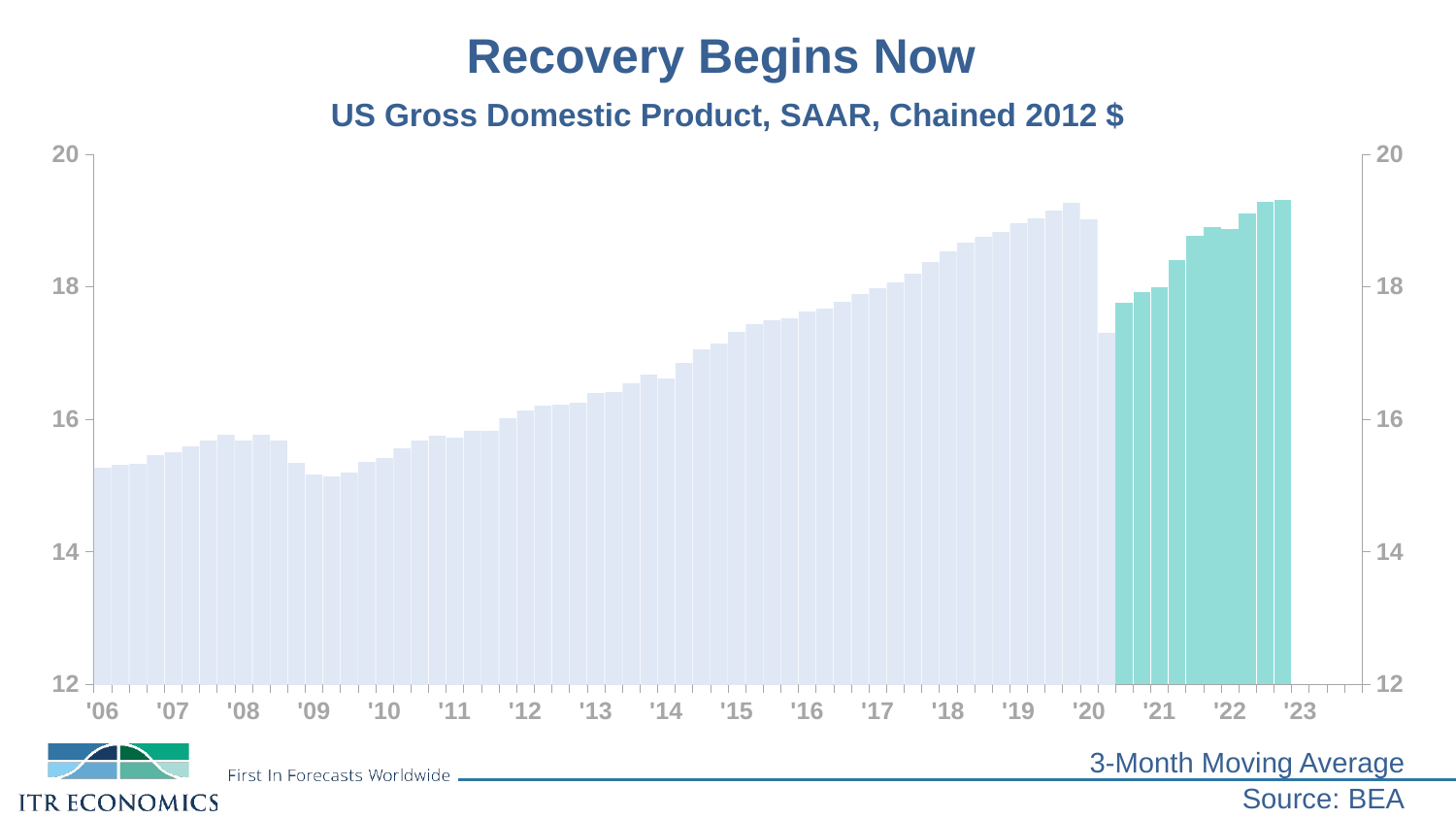
Is the value for '06 greater or less than 14? greater Is the value for '19 greater or less than 18? greater Do the values generally rise or fall from '10 to '19? rise Is the value for '09 greater or less than 16? less Do the values rise or fall from '08 to '09? fall What is the title of the chart on the slide? US Gross Domestic Product, SAAR, Chained 2012 $ What kind of chart is shown on the slide? bar chart What source is cited for the chart data? BEA